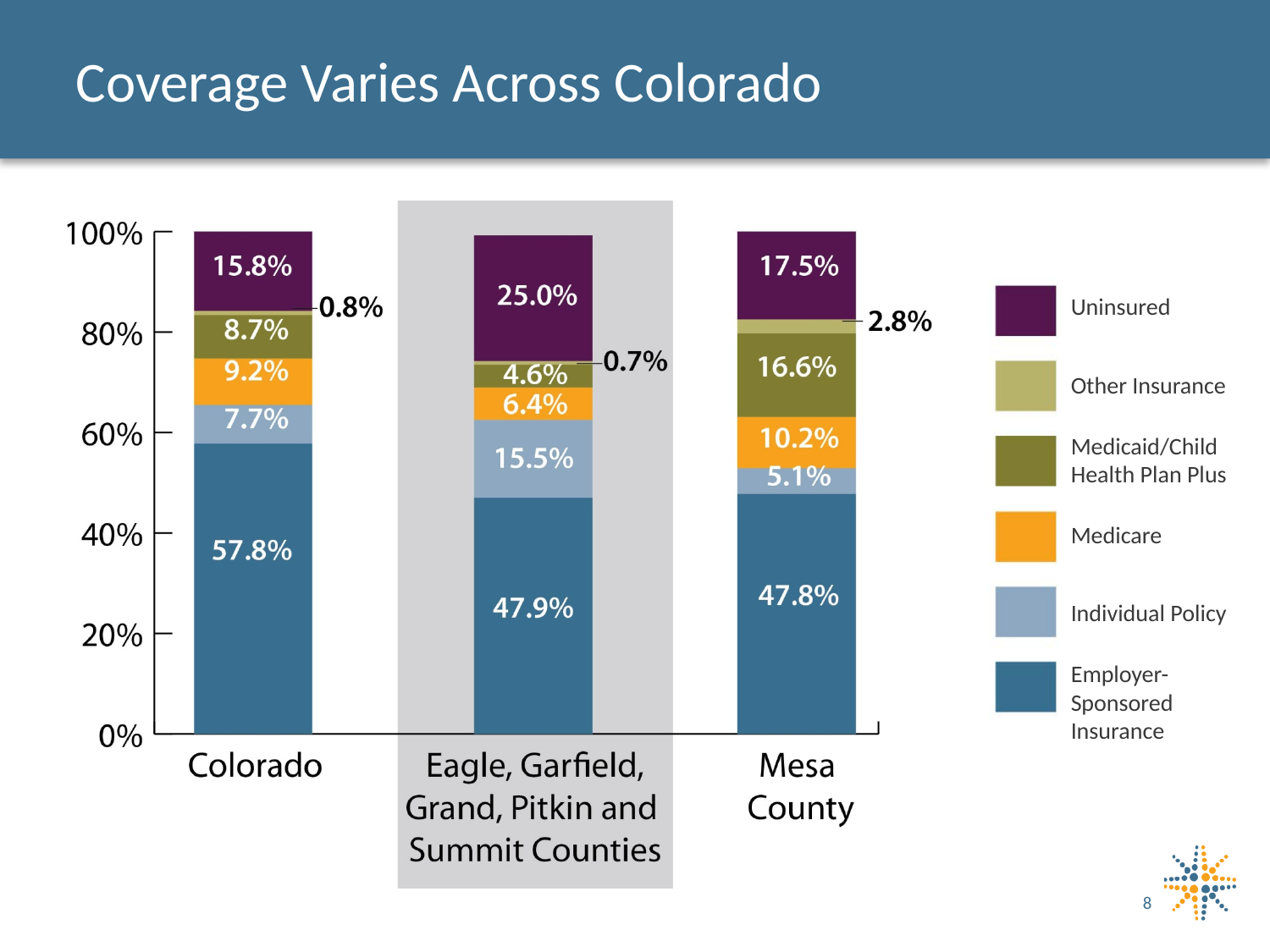
What type of chart is shown on the slide? Stacked bar chart What is the Medicaid/Child Health Plan Plus value for Mesa County? 16.6% How many coverage types does the legend list? 6 What percentage of Colorado's coverage is Employer-Sponsored Insurance? 57.8% How many areas (bars) are shown on the chart? 3 Which area has the lowest Individual Policy percentage? Mesa County What is the Other Insurance value for Mesa County? 2.8% Which of the three areas has the highest Uninsured percentage? Eagle, Garfield, Grand, Pitkin and Summit Counties Is the Medicare share larger in Colorado or in Mesa County? Mesa County Which coverage type is shown in dark purple at the top of each bar? Uninsured What is the Uninsured share for Eagle, Garfield, Grand, Pitkin and Summit Counties? 25.0% What is the difference between the Uninsured percentage in Mesa County and in Colorado? 1.7%